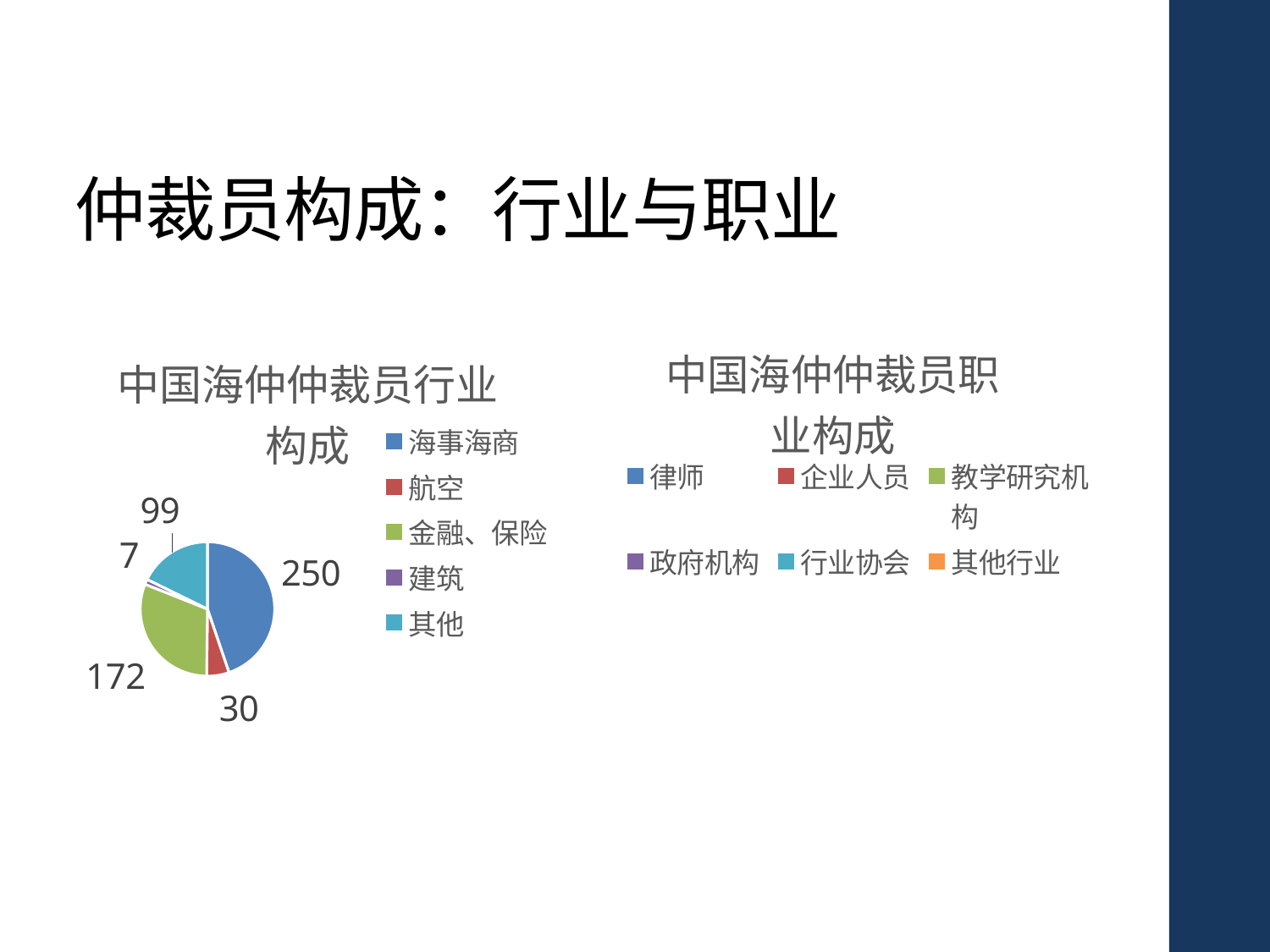
How many entries does the legend of the right chart titled 中国海仲仲裁员职业构成 list? 6 In the chart 中国海仲仲裁员行业构成, which category has the largest slice? 海事海商 In the chart 中国海仲仲裁员行业构成, what is the value for 建筑? 7 In the chart 中国海仲仲裁员行业构成, which category has the smallest slice? 建筑 In the chart 中国海仲仲裁员行业构成, which is larger, 其他 or 航空? 其他 In the chart 中国海仲仲裁员行业构成, what is the value for 金融、保险? 172 In the chart 中国海仲仲裁员行业构成, what is the value for 航空? 30 What kind of chart is the left chart titled 中国海仲仲裁员行业构成? pie chart What is the total of all values in the chart 中国海仲仲裁员行业构成? 558 In the chart 中国海仲仲裁员行业构成, what is the value for 海事海商? 250 In the chart 中国海仲仲裁员行业构成, what is the difference between the values for 海事海商 and 金融、保险? 78 How many categories does the chart 中国海仲仲裁员行业构成 show? 5